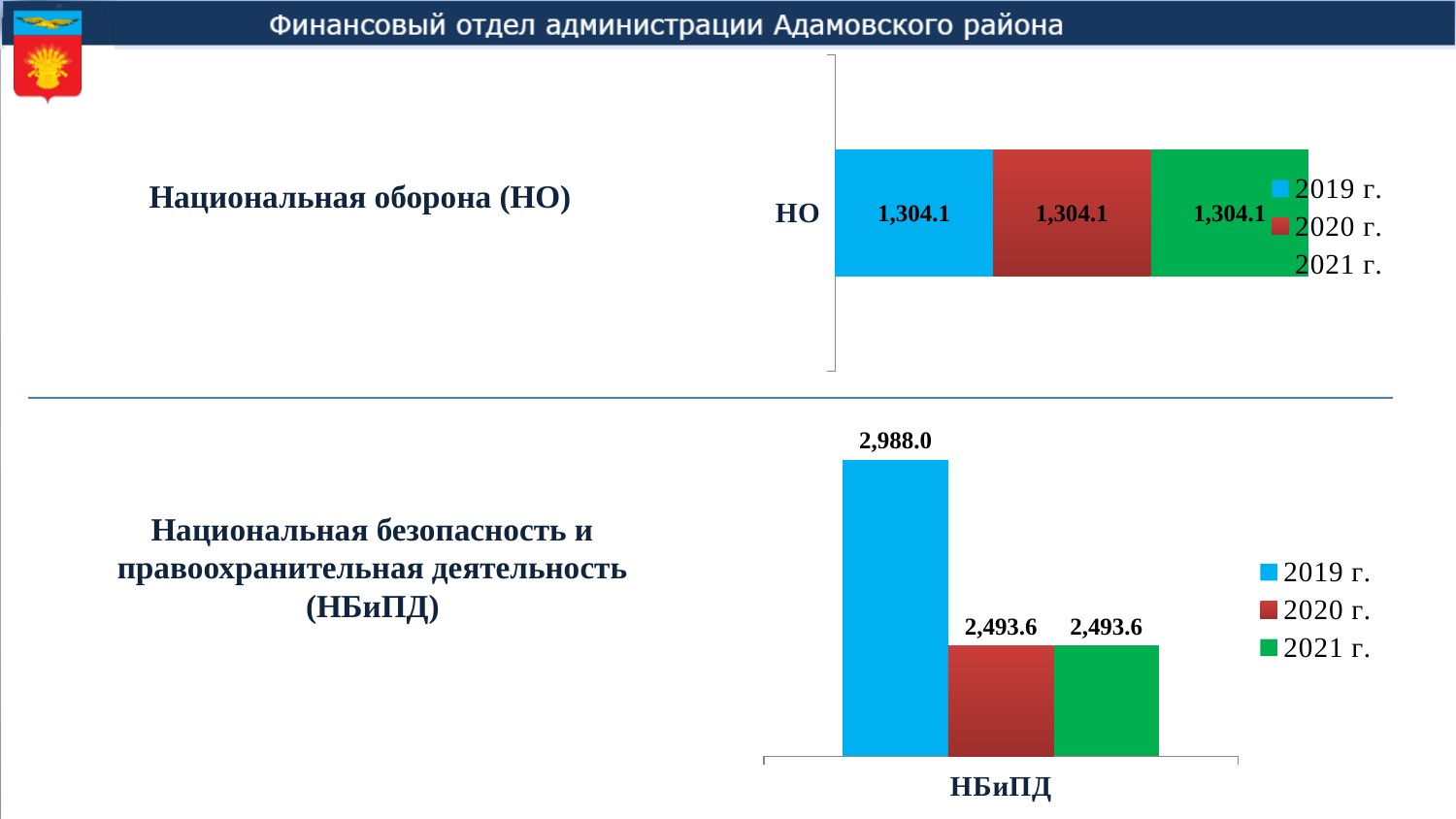
In the bottom chart (НБиПД), what is the difference between the 2019 г. and 2021 г. values? 494.4 In the top chart (НО), what is the value for 2021 г.? 1,304.1 In the top chart (НО), how many series does the legend list? 3 In the bottom chart (НБиПД), which year has the highest value? 2019 г. In the top chart (НО), what is the value for 2019 г.? 1,304.1 In the bottom chart (НБиПД), what is the value for 2019 г.? 2,988.0 In the top chart (НО), what is the difference between the 2020 г. and 2019 г. values? 0 In the top chart (НО), what kind of chart is shown? bar chart In the bottom chart (НБиПД), which is larger, the value for 2019 г. or 2020 г.? 2019 г. In the bottom chart (НБиПД), how many series does the legend list? 3 In the bottom chart (НБиПД), what colour represents 2021 г.? green In the bottom chart (НБиПД), what is the value for 2020 г.? 2,493.6